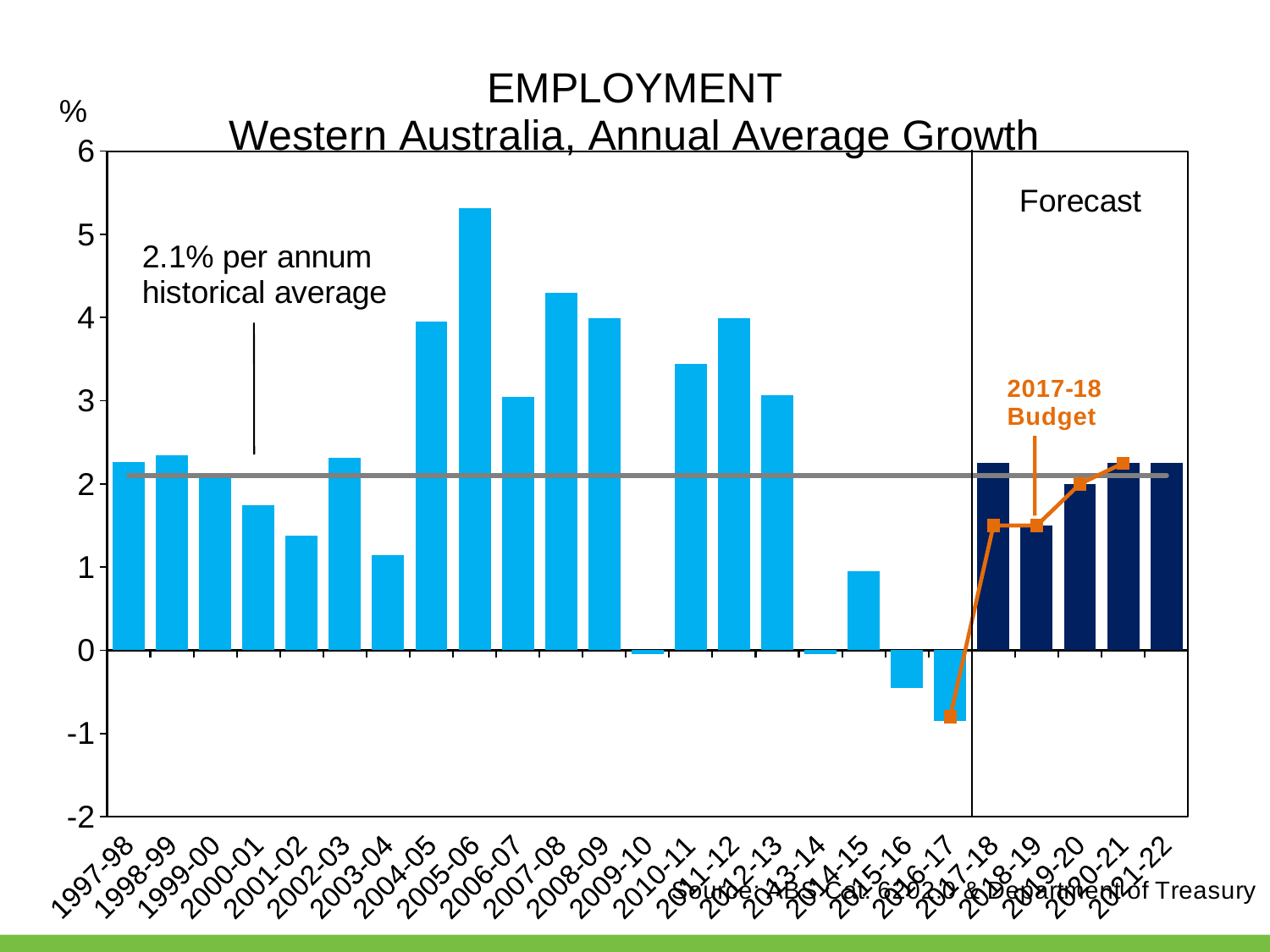
Which year has the lowest employment growth on the chart? 2016-17 Is the value for 2003-04 greater or less than 2? less Is the value for 2005-06 greater or less than 5? greater Which is larger, the value for 2005-06 or the value for 2007-08? 2005-06 Which year has the highest employment growth on the chart? 2005-06 Do the values rise or fall from 2012-13 to 2016-17? fall Is the value for 2007-08 greater or less than 4? greater What kind of chart is shown on the slide? combination bar and line chart How many years (categories) are shown on the x axis? 25 What is the historical average annual employment growth stated on the chart? 2.1% per annum What label is shown above the dark blue bars at the right of the chart? Forecast